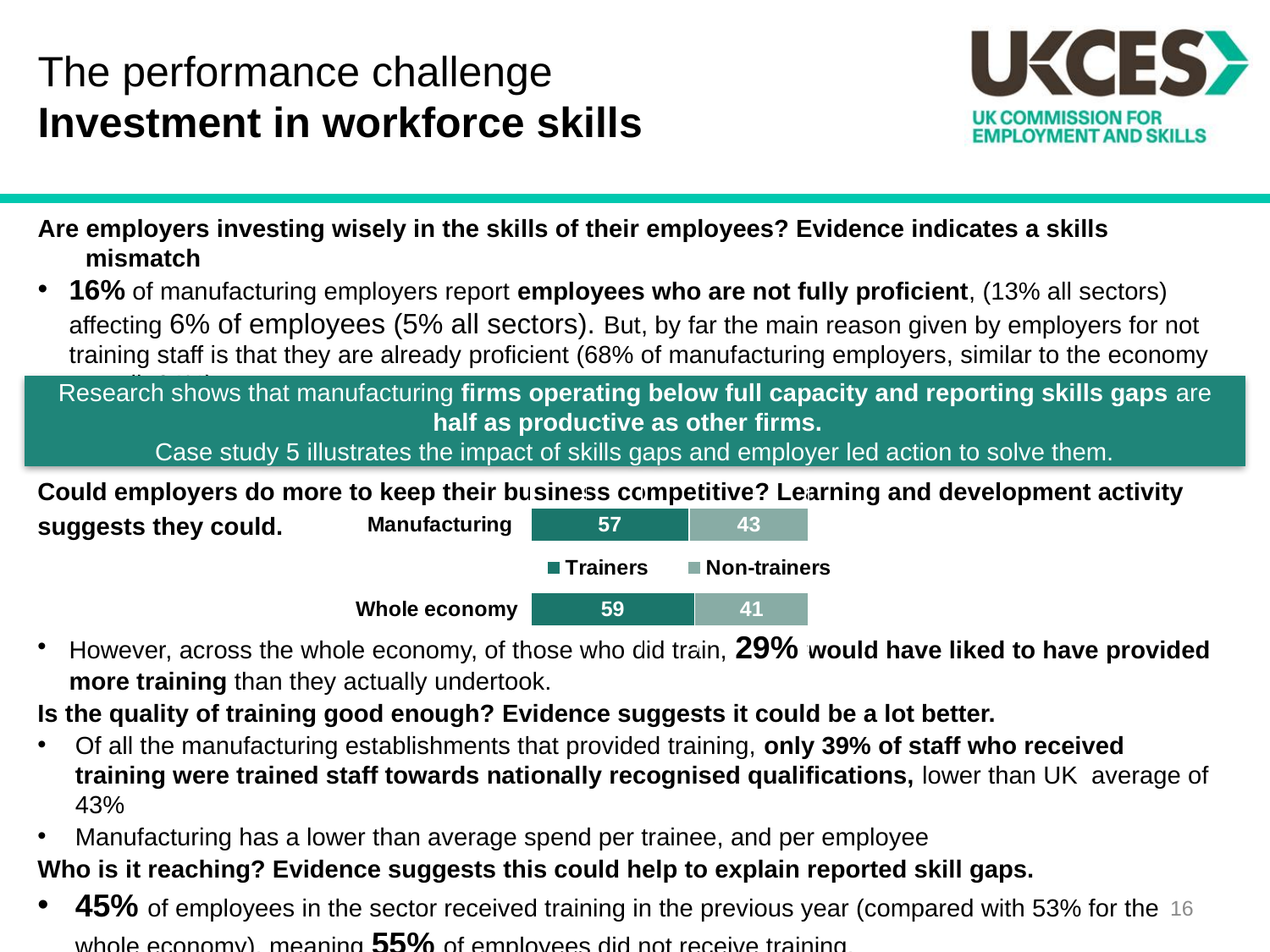
What is the Non-trainers value for Manufacturing? 43 What is the total of the stacked bar for Manufacturing? 100 What is the Non-trainers value for Whole economy? 41 What kind of chart is shown on the slide? Stacked bar chart What is the difference between the Trainers values for Whole economy and Manufacturing? 2 Which category has the lower Non-trainers value? Whole economy Is the Non-trainers value larger for Manufacturing or for Whole economy? Manufacturing How many series does the chart legend list? 2 Which category has the higher Trainers value? Whole economy How many categories are shown in the chart? 2 What is the Trainers value for Manufacturing? 57 What is the Trainers value for Whole economy? 59